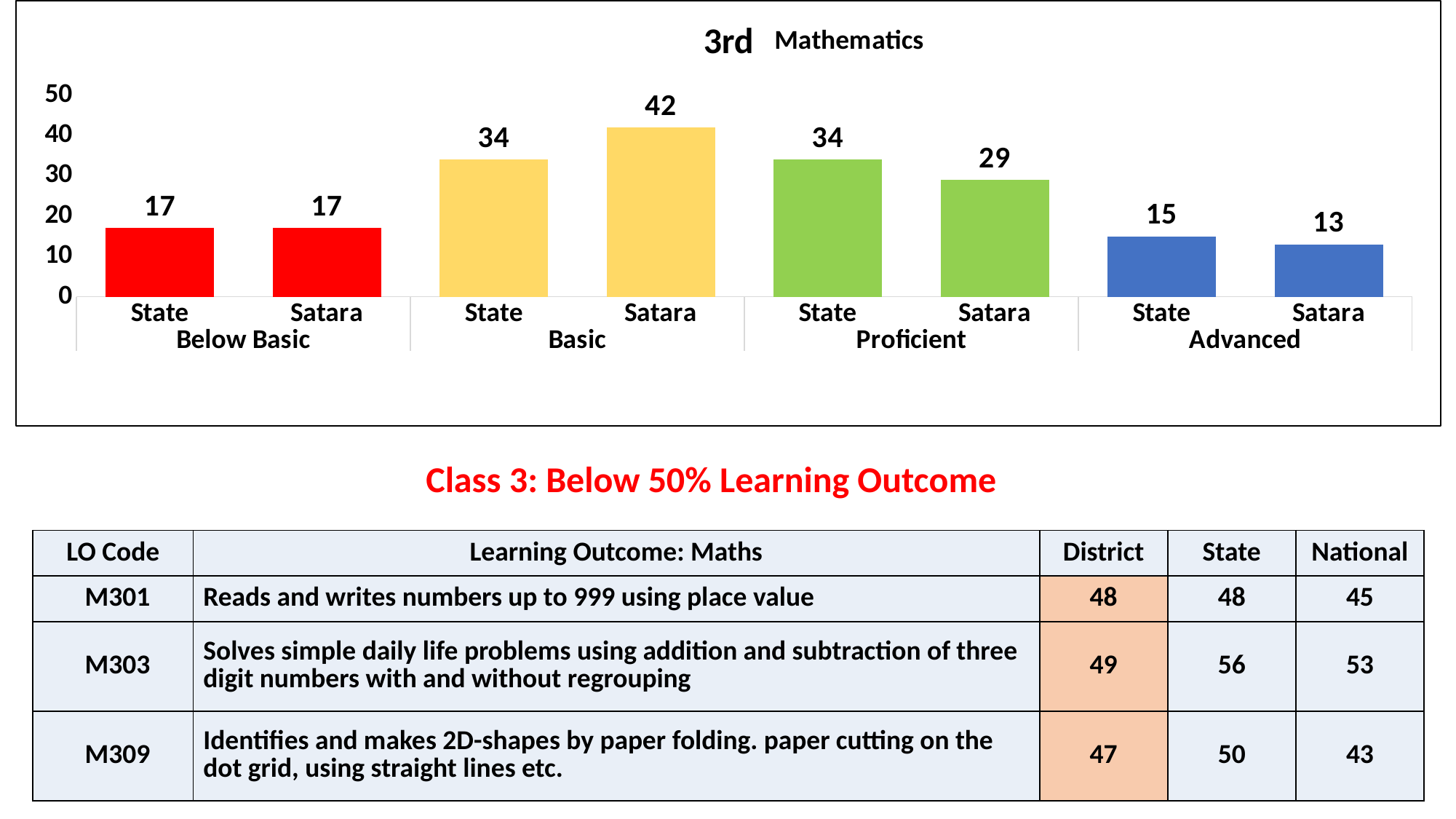
Which is larger in the Advanced category, State or Satara? State What is the title of the chart? 3rd Mathematics What is the value for State in the Below Basic category? 17 What is the value for State in the Proficient category? 34 What is the value for Satara in the Basic category? 42 What is the difference between the State and Satara values in the Proficient category? 5 What is the difference between the Satara and State values in the Basic category? 8 Which bar has the highest value in the chart? Satara, Basic What type of chart is shown on the slide? Bar chart How many bars are plotted in the chart? 8 What is the value for Satara in the Advanced category? 13 Which bar has the lowest value in the chart? Satara, Advanced